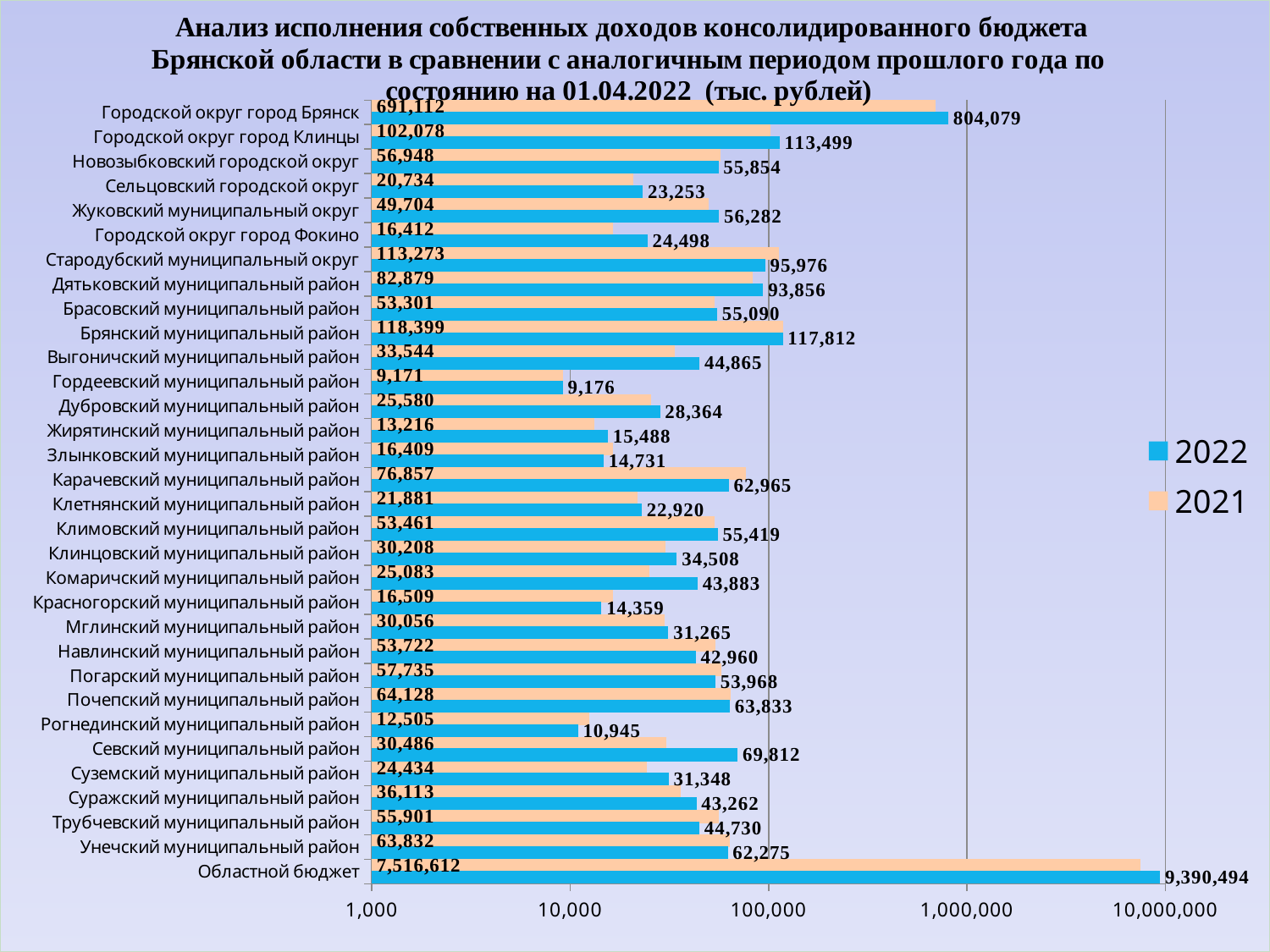
Which is larger for Карачевский муниципальный район, the 2021 value or the 2022 value? 2021 What kind of chart is shown on the slide? Bar chart What is the 2022 value for Областной бюджет? 9,390,494 How many series does the legend list? 2 Which category has the lowest 2021 value? Гордеевский муниципальный район Is the 2022 value for Городской округ город Клинцы greater or less than 100,000? greater How many categories are shown on the chart? 32 Which category has the highest 2022 value? Областной бюджет What is the 2021 value for Севский муниципальный район? 30,486 What is the 2022 value for Городской округ город Брянск? 804,079 What is the difference between the 2022 and 2021 values for Севский муниципальный район? 39,326 What is the 2021 value for Стародубский муниципальный округ? 113,273